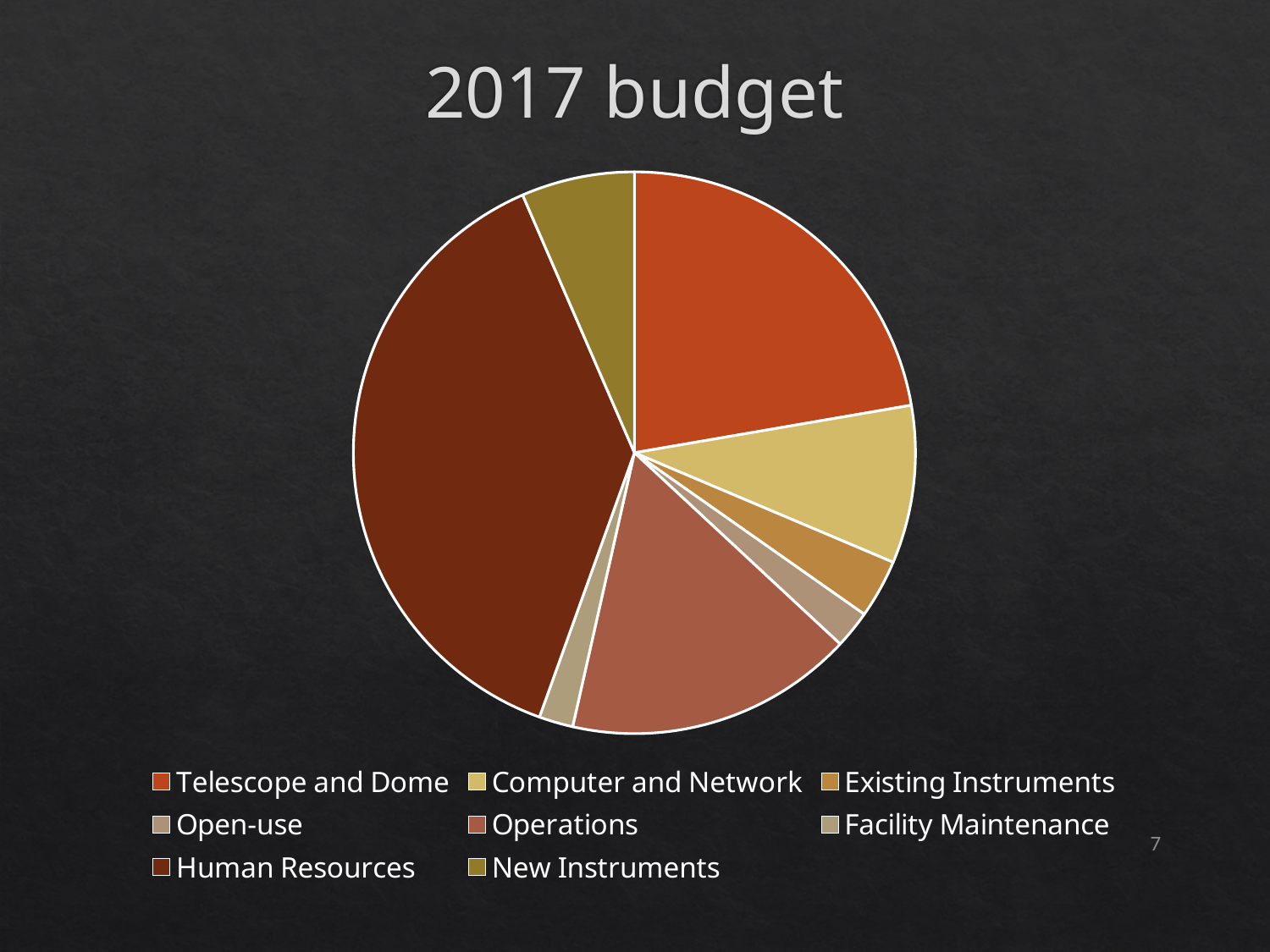
Which is larger, the slice for Operations or the slice for New Instruments? Operations What is the title of the chart? 2017 budget Which category is shown in the dark brown colour that makes up the largest slice? Human Resources What kind of chart is shown on the slide? Pie chart Which category has the largest slice of the pie? Human Resources Which is larger, the slice for Telescope and Dome or the slice for Human Resources? Human Resources Which is larger, the slice for Human Resources or the slice for Operations? Human Resources How many categories does the pie chart have? 8